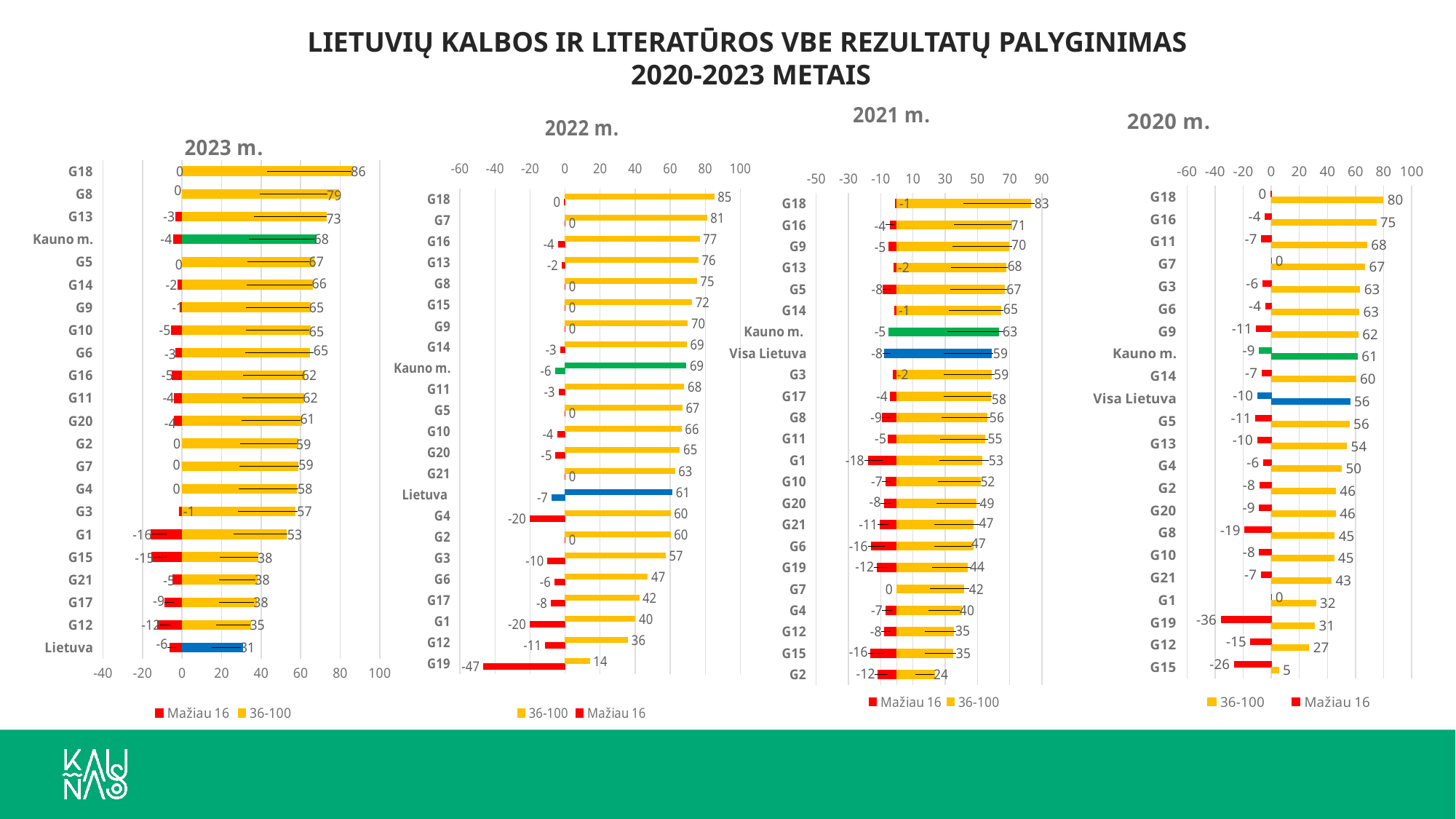
In the 2021 m. chart, which category has the highest 36-100 value? G18 How many series does the legend of the 2021 m. chart list? 2 In the 2020 m. chart, which category has the lowest 36-100 value? G15 In the 2022 m. chart, what is the Mažiau 16 value for G19? -47 In the 2022 m. chart, which has the larger 36-100 value, Kauno m. or Lietuva? Kauno m. In the 2021 m. chart, what is the 36-100 value for Visa Lietuva? 59 In the 2020 m. chart, what is the Mažiau 16 value for G19? -36 What kind of chart is the 2020 m. chart? Bar chart In the 2023 m. chart, what is the difference between the 36-100 values for Kauno m. and Lietuva? 37 In the 2023 m. chart, what is the 36-100 value for G18? 86 In the 2022 m. chart, which category has the lowest Mažiau 16 value? G19 How many categories are shown in the 2020 m. chart? 22